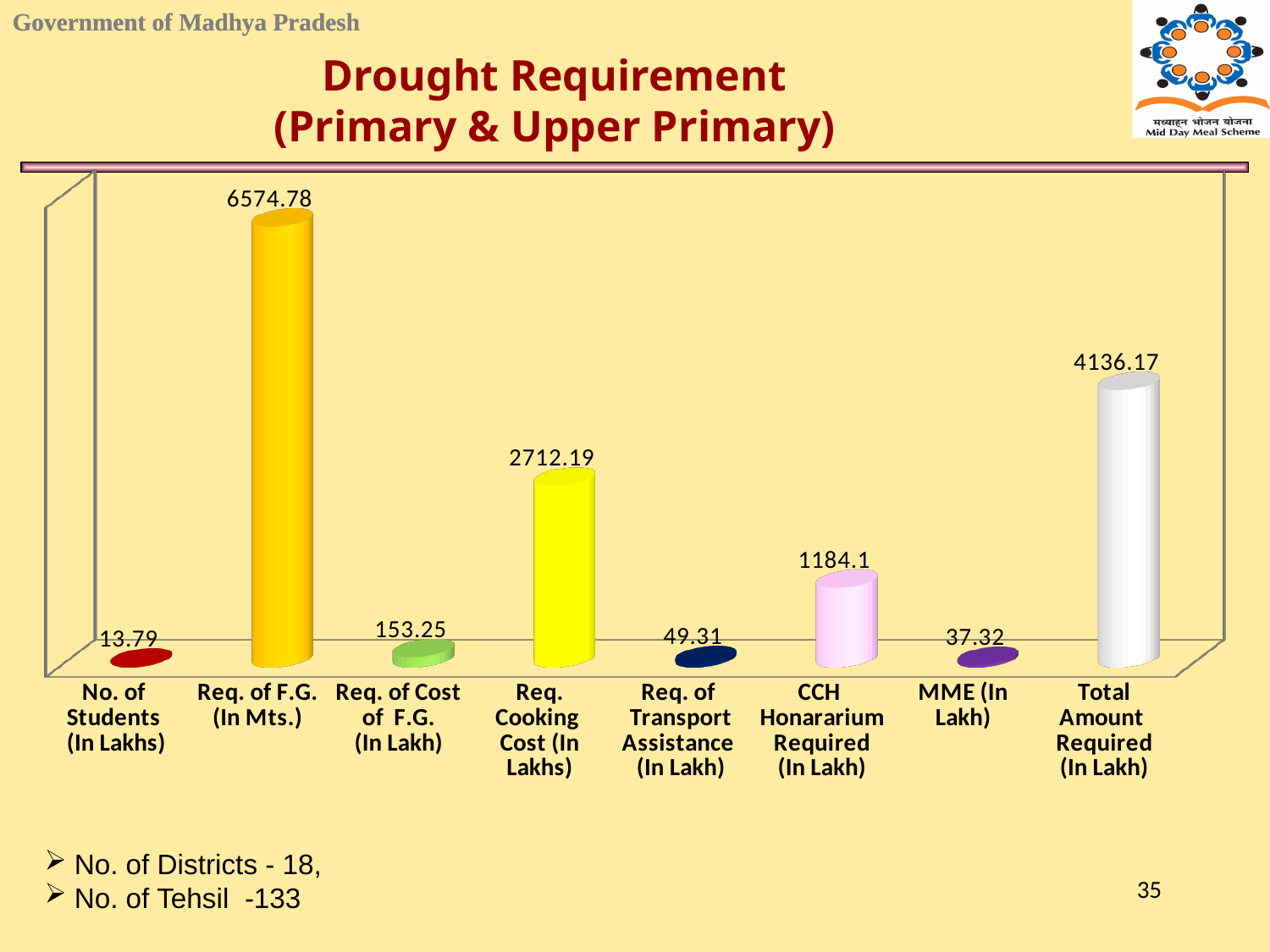
What kind of chart is shown on the slide? Bar chart Which category has the lowest value in the chart? No. of Students (In Lakhs) What is the value shown for CCH Honararium Required (In Lakh)? 1184.1 What is the difference between Req. of Cost of F.G. (In Lakh) and Req. of Transport Assistance (In Lakh)? 103.94 How many categories are plotted in the chart? 8 What is the difference between Total Amount Required (In Lakh) and Req. Cooking Cost (In Lakhs)? 1423.98 Which category has the highest value in the chart? Req. of F.G. (In Mts.) What is the value shown for Req. of F.G. (In Mts.)? 6574.78 What is the value shown for Req. of Transport Assistance (In Lakh)? 49.31 What is the value shown for MME (In Lakh)? 37.32 What is the value shown for Total Amount Required (In Lakh)? 4136.17 Which is larger, Req. Cooking Cost (In Lakhs) or CCH Honararium Required (In Lakh)? Req. Cooking Cost (In Lakhs)